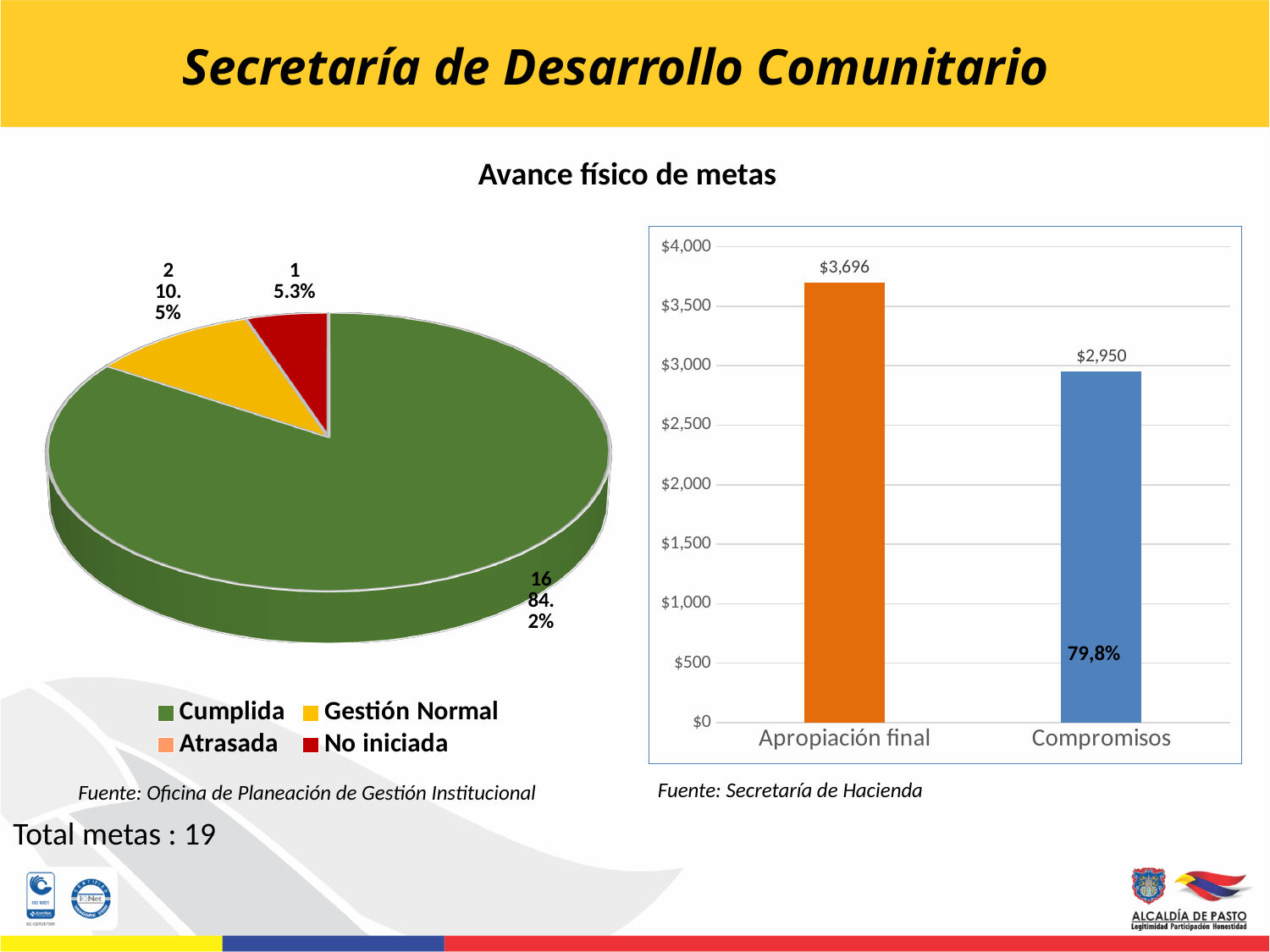
In the bar chart on the right, what is the value for Compromisos? $2,950 In the bar chart on the right, what is the difference between Apropiación final and Compromisos? $746 In the bar chart on the right, what is the value for Apropiación final? $3,696 In the pie chart on the left, how many metas are labelled Cumplida? 16 In the bar chart on the right, what percentage is printed on the Compromisos bar? 79,8% In the pie chart on the left, how many entries does the legend list? 4 In the pie chart on the left, what percentage share does the Gestión Normal slice have? 10.5% In the pie chart on the left, what percentage share does the Cumplida slice have? 84.2% In the pie chart on the left, which category has the largest slice? Cumplida In the pie chart on the left, how many metas are in the No iniciada slice? 1 What kind of chart is the chart on the left of the slide? Pie chart In the bar chart on the right, which is larger, Apropiación final or Compromisos? Apropiación final